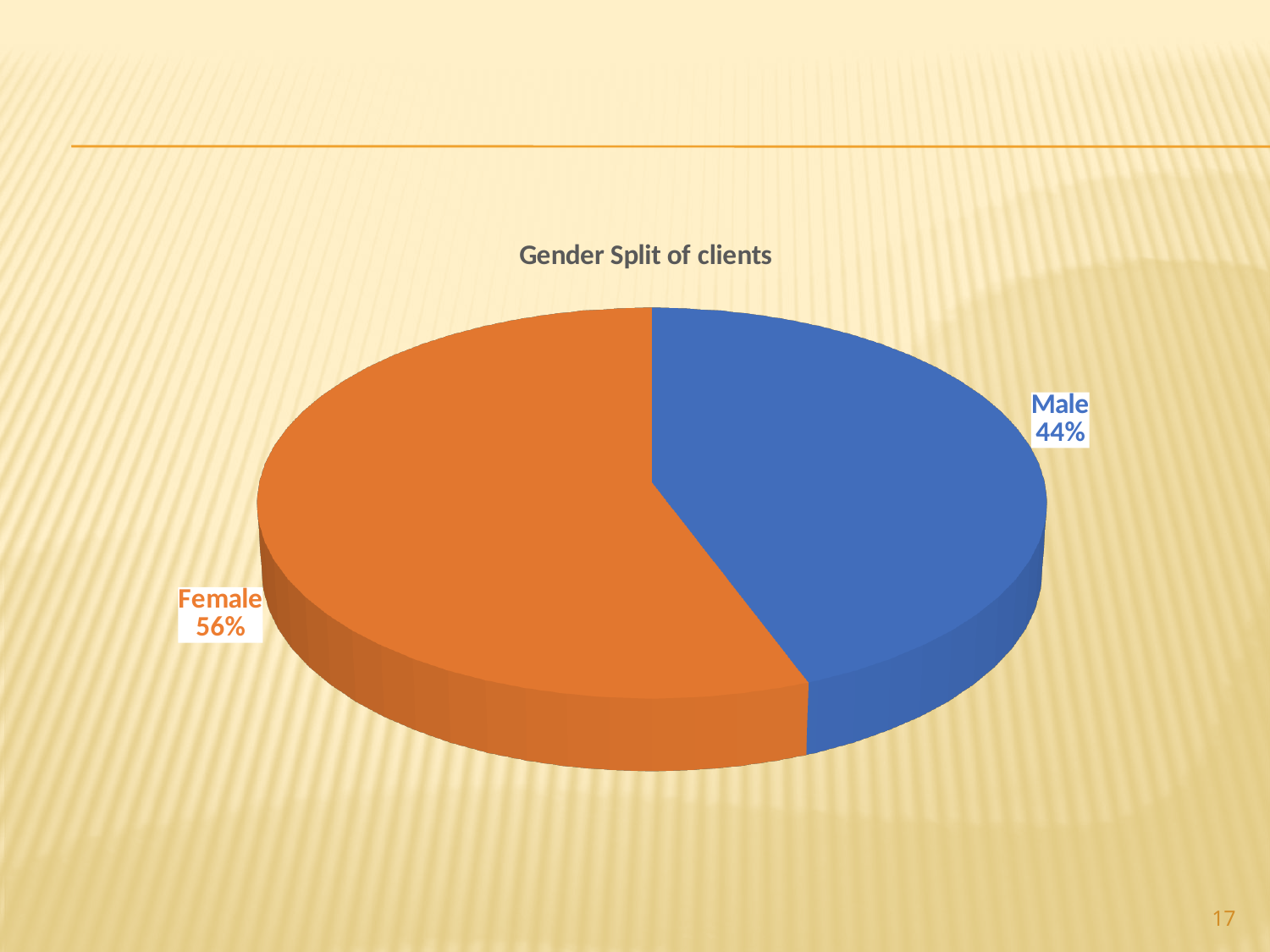
Which is larger, the share of female clients or the share of male clients? Female What kind of chart is shown on the slide? Pie chart What is the title of the chart? Gender Split of clients What percentage of clients are male? 44% What is the difference in percentage points between the female and male shares of clients? 12 Which gender makes up the largest share of clients? Female How many slices does the pie chart have? 2 Which gender makes up the smallest share of clients? Male What share of the pie does the Male slice represent? 44% What colour is the Female slice of the pie chart? Orange What percentage of clients are female? 56%